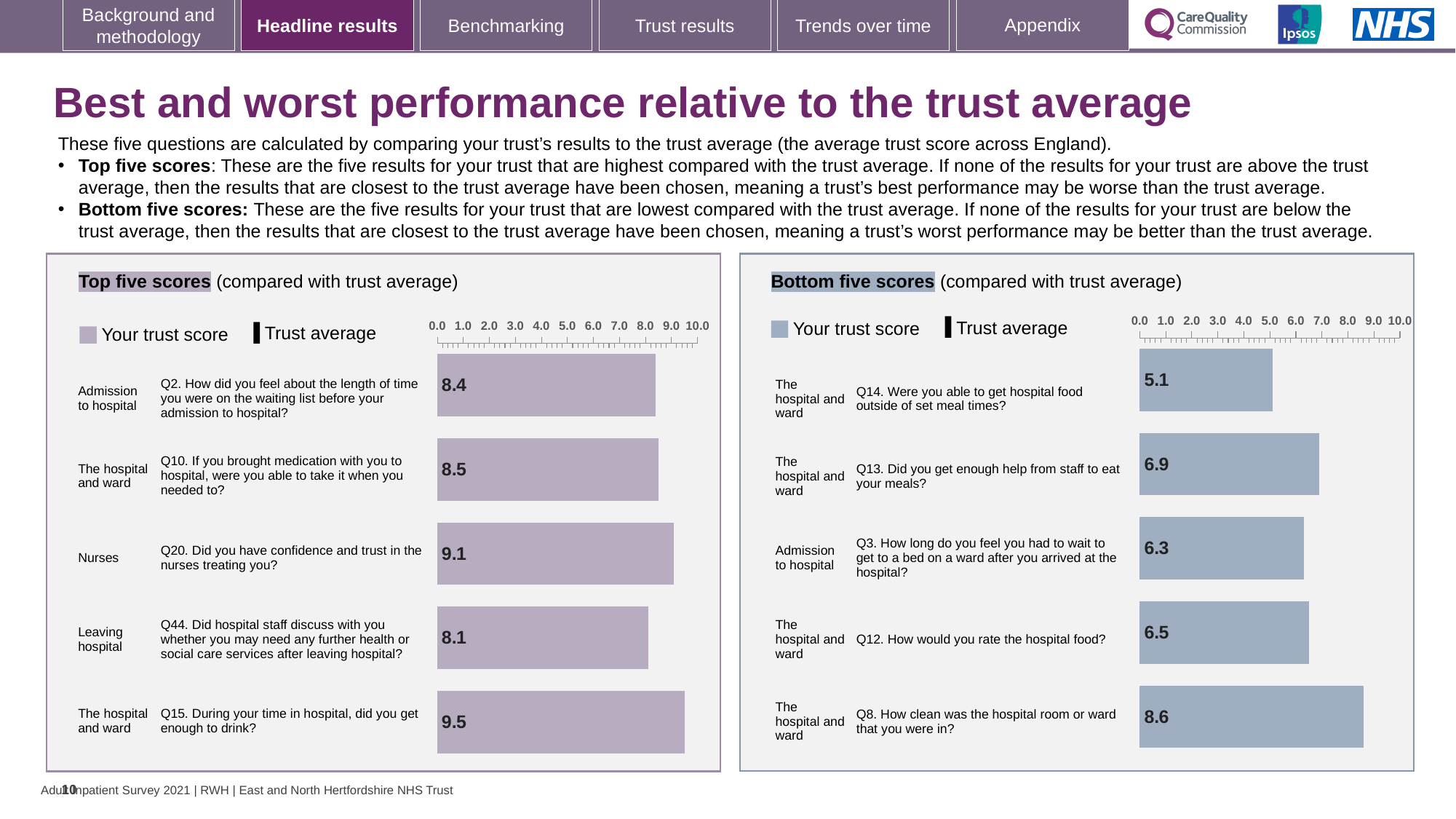
In the Top five scores chart, what is the trust score for Q2 about the length of time on the waiting list before admission? 8.4 In the Bottom five scores chart, is the score for Q3 greater or less than 7.0? less In the Top five scores chart, which question has the highest trust score? Q15. During your time in hospital, did you get enough to drink? In the Bottom five scores chart, which question has the lowest trust score? Q14. Were you able to get hospital food outside of set meal times? What is the maximum value shown on the axis of the Top five scores chart? 10.0 In the Bottom five scores chart, which has the larger score, Q13 or Q12? Q13 In the Bottom five scores chart, what is the trust score for Q14 (getting hospital food outside of set meal times)? 5.1 In the Bottom five scores chart, what is the trust score for Q8 about how clean the hospital room or ward was? 8.6 In the Top five scores chart, what is the difference between the scores for Q15 and Q44? 1.4 In the Top five scores chart, what is the trust score for Q20 (confidence and trust in the nurses treating you)? 9.1 What type of chart is used in the Top five scores panel? bar chart How many questions are shown in the Bottom five scores chart? 5